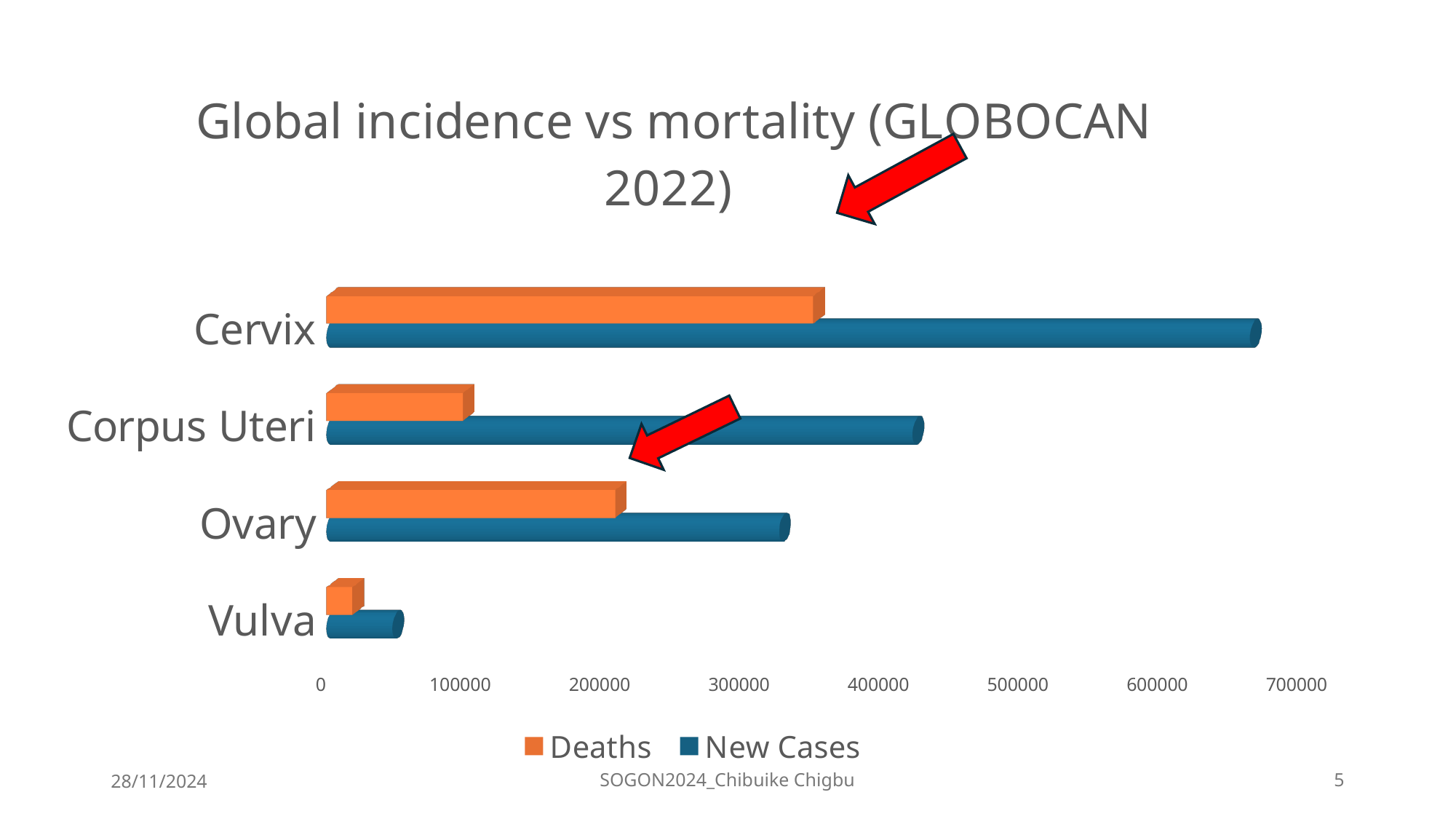
Which category has the lowest number of Deaths? Vulva Is the value for Deaths for Cervix greater or less than 300000? greater Which is larger: New Cases for Corpus Uteri or New Cases for Ovary? Corpus Uteri How many cancer sites (categories) are shown on the chart? 4 Which category has the highest number of New Cases? Cervix Which is larger: Deaths for Ovary or Deaths for Corpus Uteri? Ovary Is the value for New Cases for Ovary greater or less than 300000? greater Which colour represents the Deaths series in the legend? Orange Is the value for New Cases for Vulva greater or less than 100000? less How many series does the legend list? 2 What kind of chart is shown on the slide? Bar chart